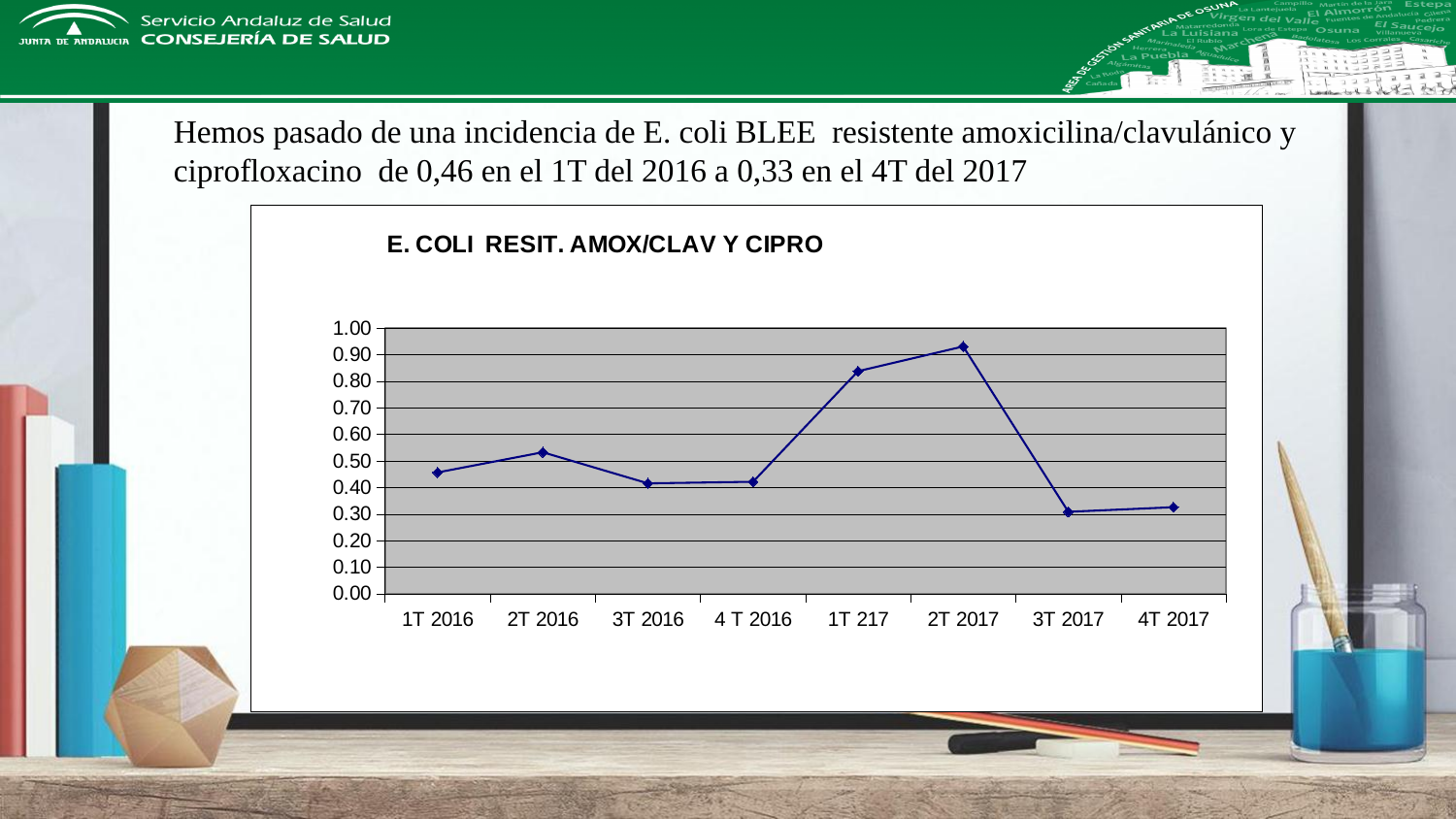
Does the line rise or fall between 2T 2017 and 3T 2017? Fall Which quarter has the highest value in the chart? 2T 2017 Is the value for 2T 2017 greater or less than 0.80? greater What type of chart is shown on the slide? Line chart Is the value for 3T 2017 greater or less than 0.40? less How many quarters (data points) are plotted on the x axis of the chart? 8 Which is larger, the value for 4 T 2016 or the value for 1T 217? 1T 217 What is the title of the chart? E. COLI RESIT. AMOX/CLAV Y CIPRO Is the value for 1T 217 greater or less than 0.80? greater Which is larger, the value for 2T 2016 or the value for 3T 2016? 2T 2016 According to the slide text, what was the incidence value in 1T 2016? 0,46